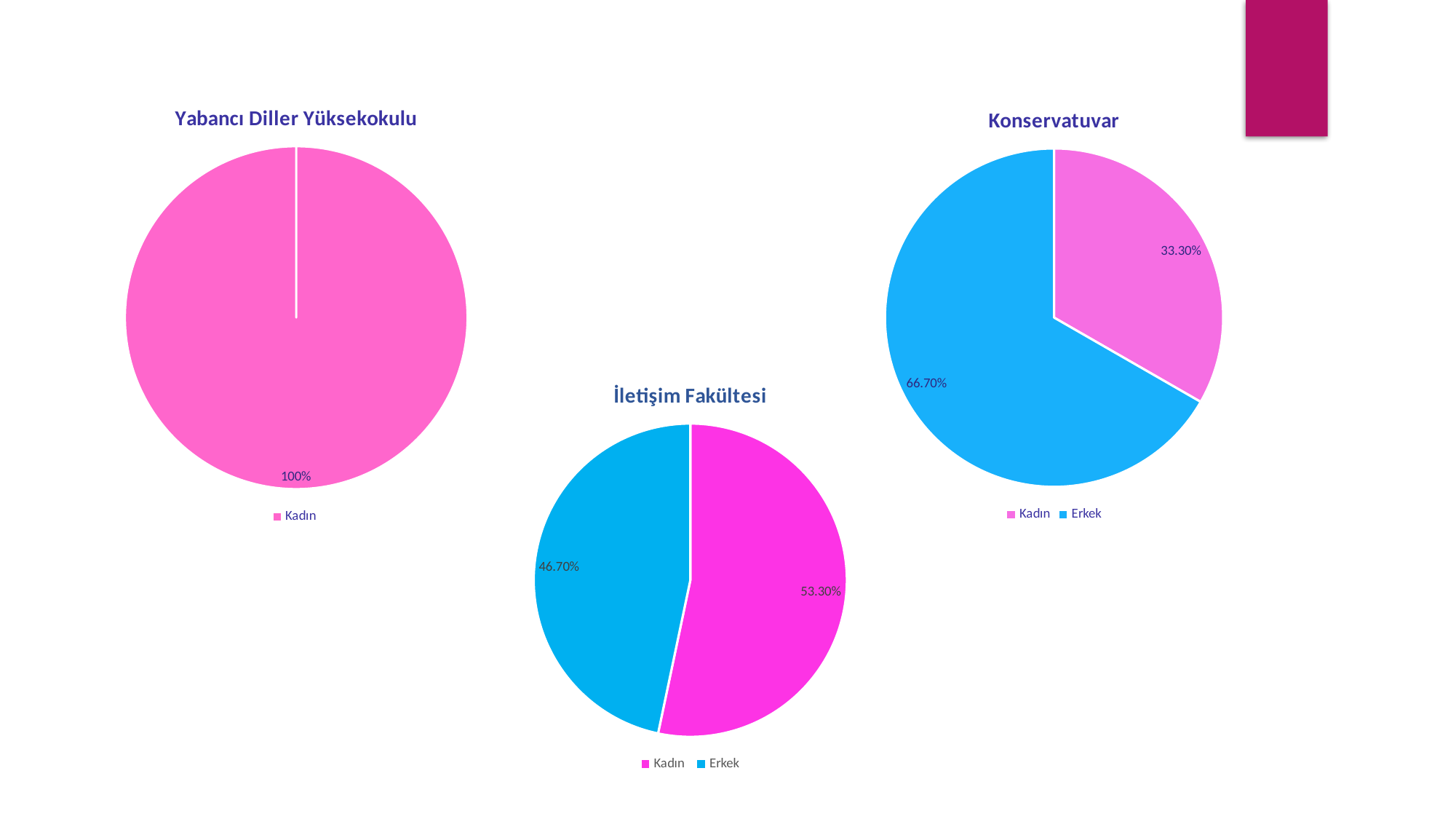
In the 'Yabancı Diller Yüksekokulu' chart, what share does Kadın have? 100% In the 'Konservatuvar' chart, what is the value for Kadın? 33.30% In the 'Konservatuvar' chart, what is the value for Erkek? 66.70% In the 'İletişim Fakültesi' chart, what is the value for Kadın? 53.30% How many charts are shown on the slide? 3 In the 'İletişim Fakültesi' chart, which is larger, Kadın or Erkek? Kadın In the 'Konservatuvar' chart, which category has the largest slice? Erkek How many categories does the legend of the 'Yabancı Diller Yüksekokulu' chart list? 1 In the 'Konservatuvar' chart, what is the difference between the Erkek and Kadın shares? 33.40% In the 'İletişim Fakültesi' chart, what is the value for Erkek? 46.70% In the 'İletişim Fakültesi' chart, which category has the smallest slice? Erkek What kind of chart is the 'Konservatuvar' chart? Pie chart